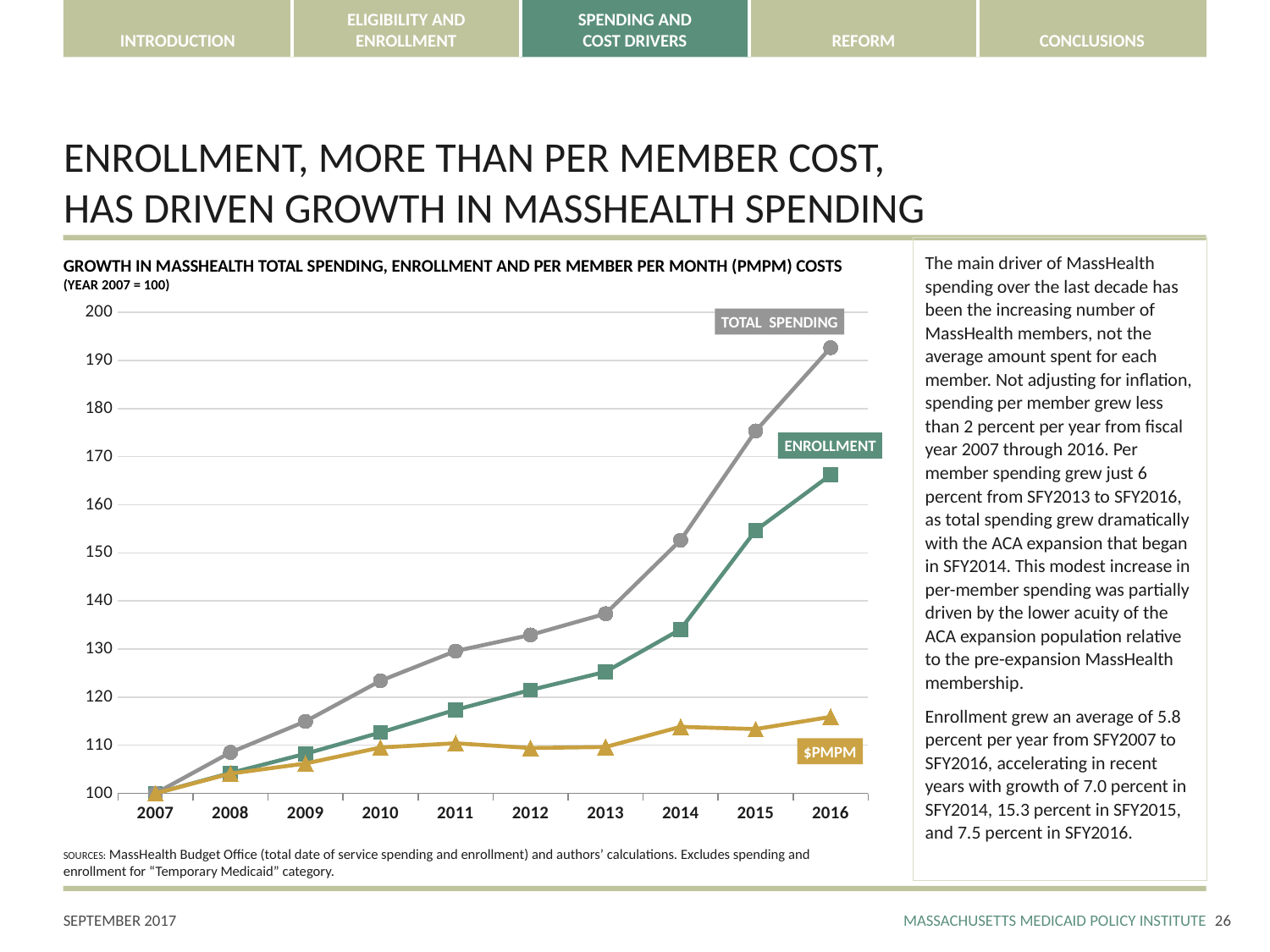
What type of chart is shown on the slide? line chart In 2014, which is larger: Enrollment or $PMPM? Enrollment Is the value for Total Spending in 2016 greater or less than 180? greater Is the value for $PMPM in 2016 greater or less than 120? less Is the value for Enrollment in 2013 greater or less than 130? less According to the chart subtitle, what is the index value for the base year 2007? 100 Which series has the highest value in 2016? Total Spending Does the Total Spending series rise or fall from 2007 to 2016? rise Which series has the lowest value in 2016? $PMPM How many years are plotted along the x axis of the chart? 10 How many series are plotted in the chart? 3